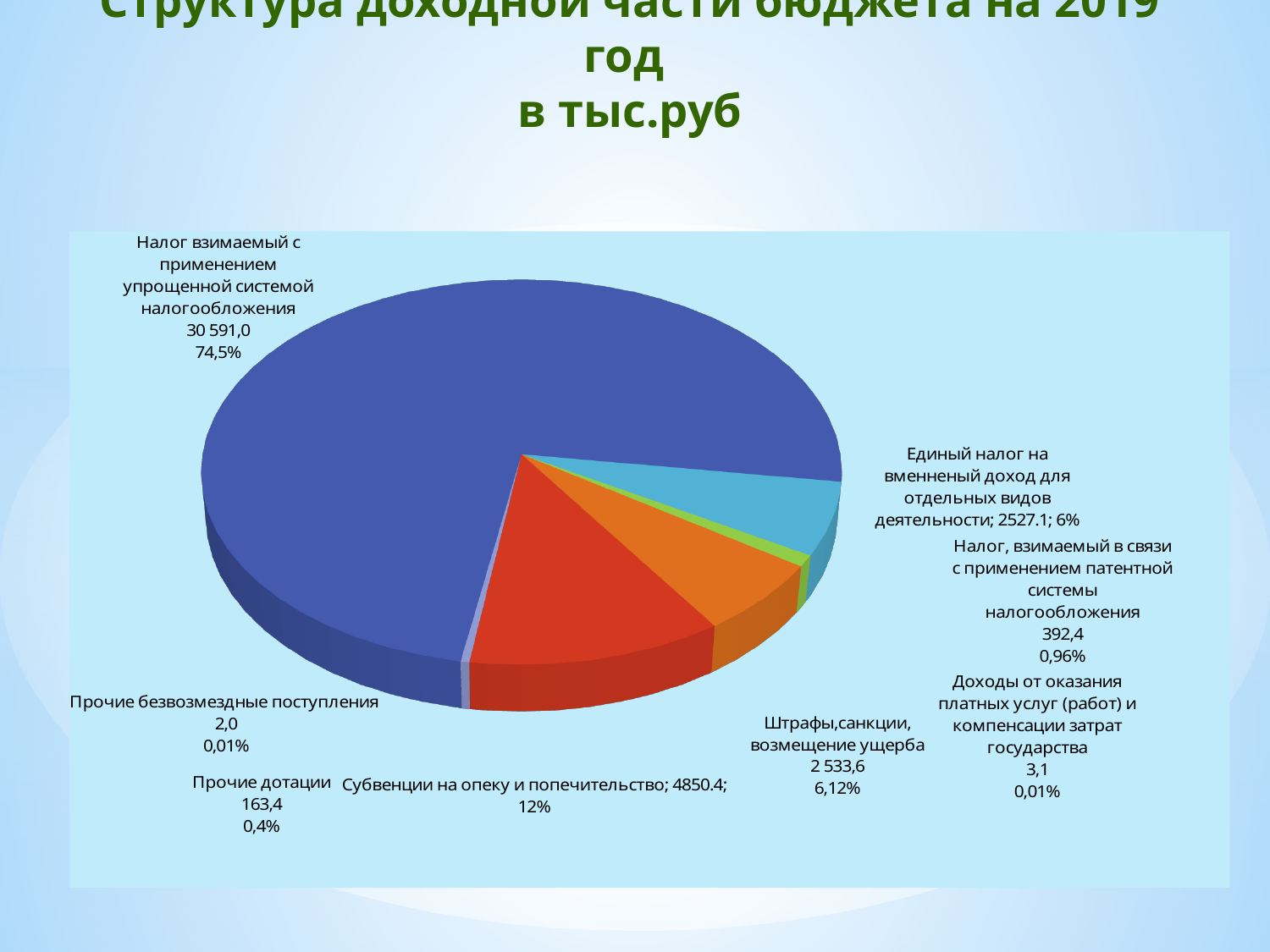
What share of the pie does 'Штрафы,санкции, возмещение ущерба' represent? 6,12% What share of the pie does 'Доходы от оказания платных услуг (работ) и компенсации затрат государства' represent? 0,01% Which is larger: 'Штрафы,санкции, возмещение ущерба' or 'Единый налог на вменненый доход для отдельных видов деятельности'? Штрафы,санкции, возмещение ущерба What kind of chart is shown on the slide? pie chart What is the difference between the values for 'Субвенции на опеку и попечительство' and 'Штрафы,санкции, возмещение ущерба'? 2316,8 How many categories (slices) does the pie chart show? 8 What is the value for 'Налог, взимаемый в связи с применением патентной системы налогообложения'? 392,4 What is the value for 'Налог взимаемый с применением упрощенной системой налогообложения'? 30 591,0 What is the value for 'Прочие дотации'? 163,4 Which category has the largest slice of the pie? Налог взимаемый с применением упрощенной системой налогообложения What is the value for 'Субвенции на опеку и попечительство'? 4850.4 What share of the pie does 'Налог взимаемый с применением упрощенной системой налогообложения' represent? 74,5%